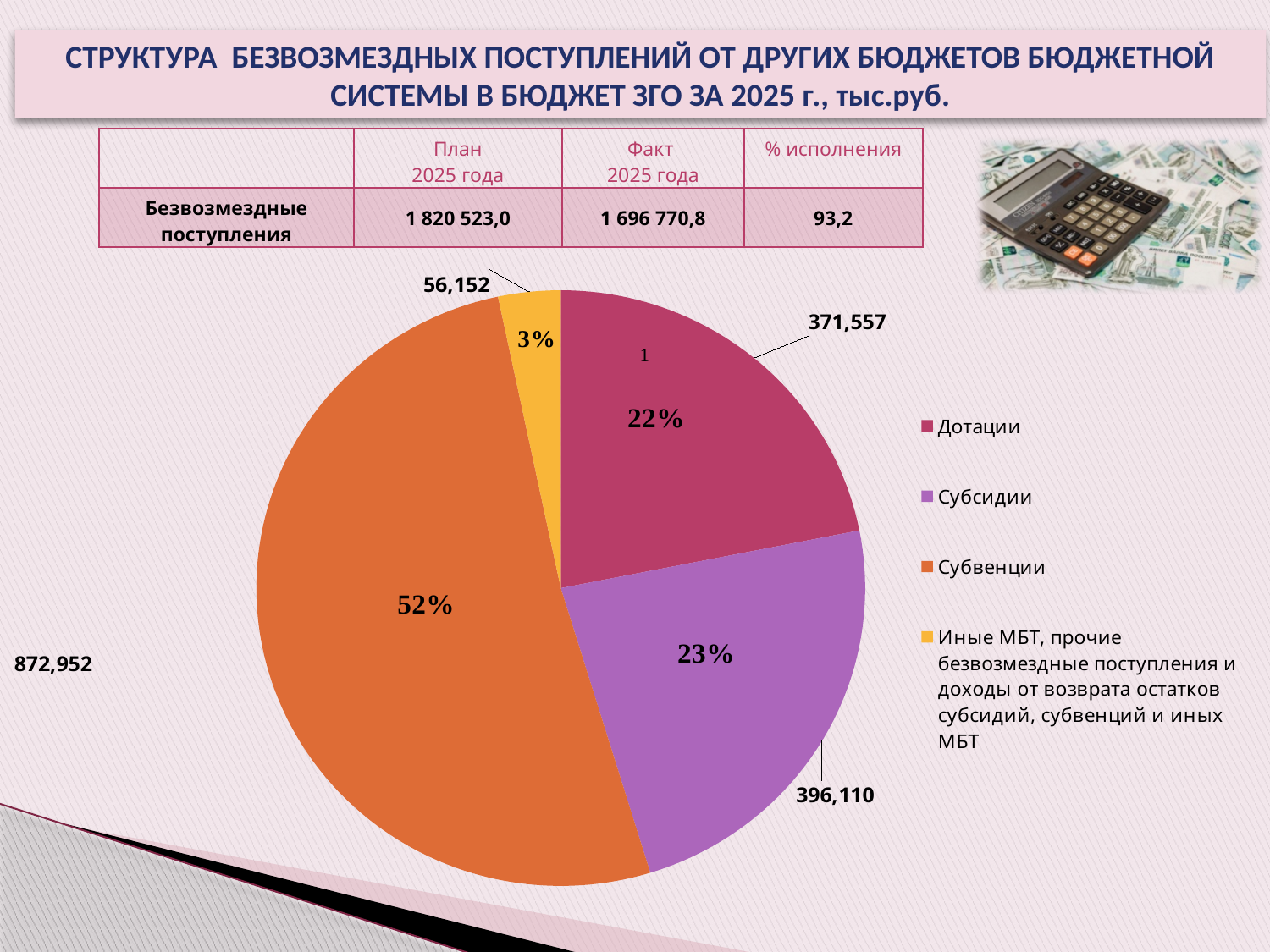
What kind of chart is shown on the slide? pie chart How many entries does the legend of the pie chart list? 4 Which is larger in the pie chart, Субсидии or Дотации? Субсидии What is the value for Дотации in the pie chart? 371,557 Which category has the largest slice in the pie chart? Субвенции How many slices does the pie chart have? 4 What share of the pie does Субсидии represent? 23% Which category has the smallest slice in the pie chart? Иные МБТ, прочие безвозмездные поступления и доходы от возврата остатков субсидий, субвенций и иных МБТ What is the value for Субсидии in the pie chart? 396,110 What share of the pie does Субвенции represent? 52% What is the value for Субвенции in the pie chart? 872,952 What is the difference between the values for Субвенции and Субсидии in the pie chart? 476,842